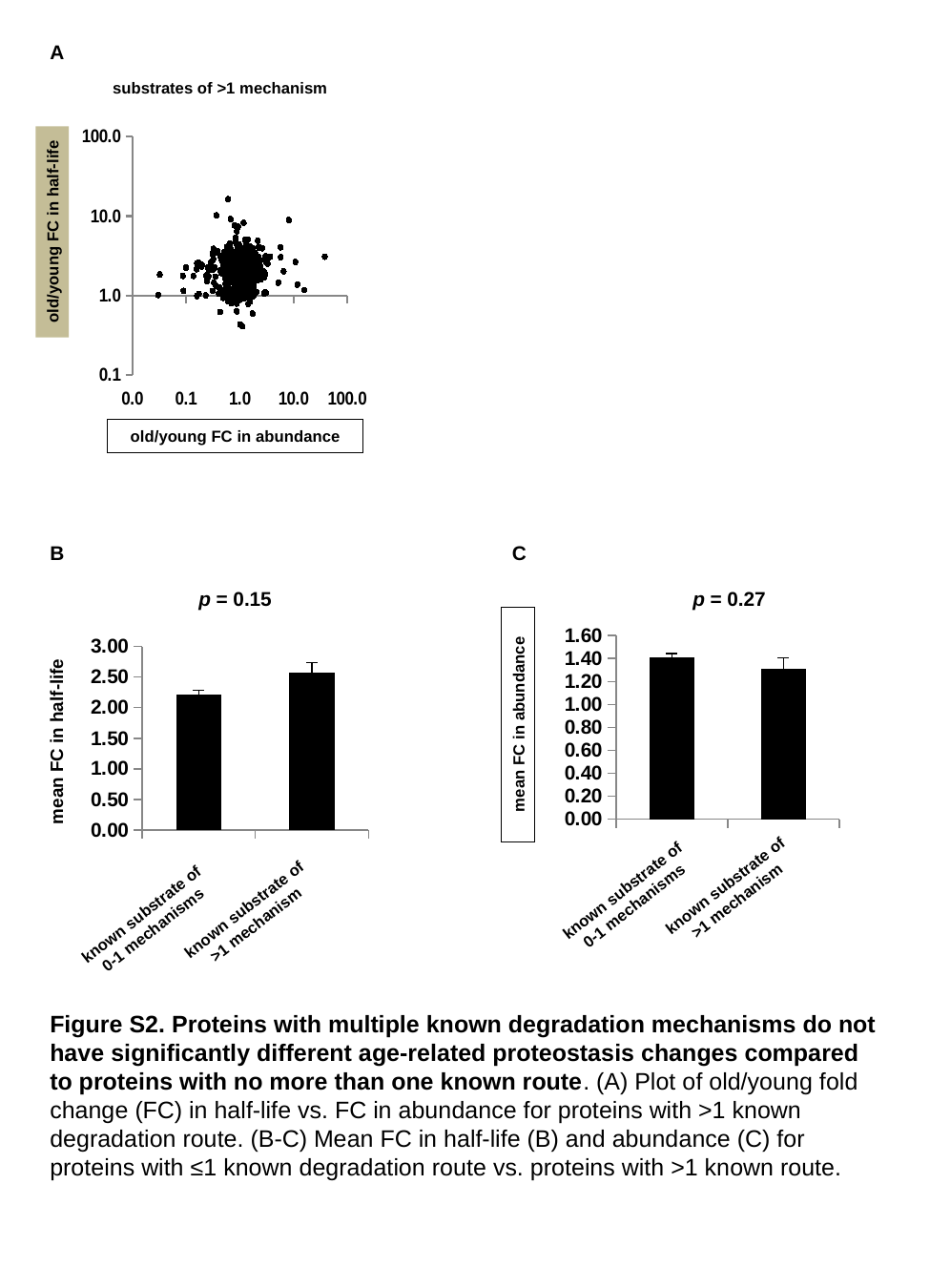
In chart B, is the value for "known substrate of >1 mechanism" greater or less than 3.00? less In chart B, is the value for "known substrate of 0-1 mechanisms" greater or less than 2.00? greater In chart B, which category has the higher mean FC in half-life? known substrate of >1 mechanism What kind of chart is chart B (the left chart in the bottom row)? bar chart What kind of chart is chart A, titled "substrates of >1 mechanism"? scatter plot How many bars (categories) are shown in chart B? 2 In chart C, is the value for "known substrate of 0-1 mechanisms" greater or less than 1.20? greater In chart A, what is the label of the x axis? old/young FC in abundance How many bars (categories) are shown in chart C? 2 In chart A, what is the label of the y axis? old/young FC in half-life What p value is printed above chart C? p = 0.27